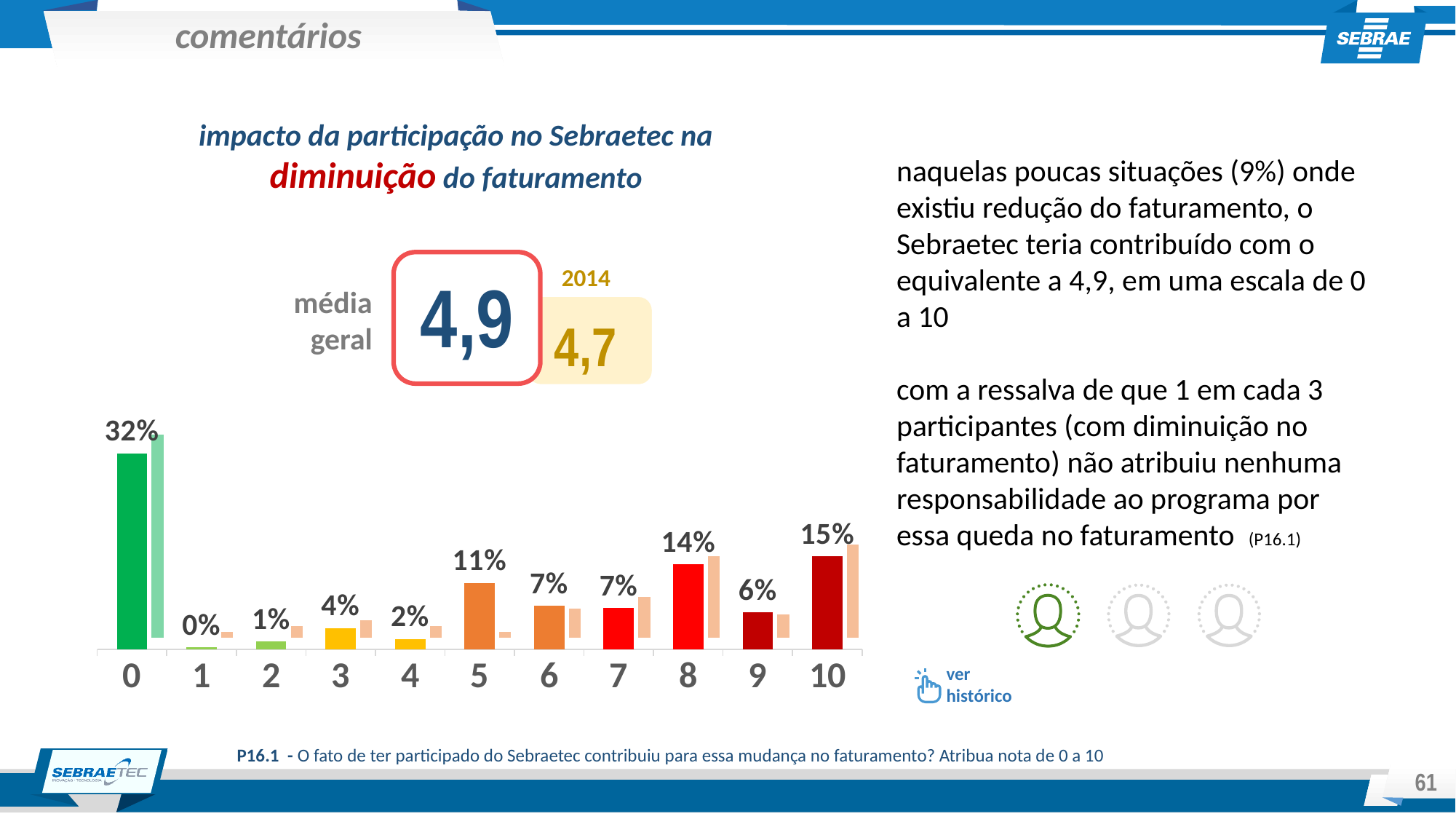
What percentage of participants gave a score of 10? 15% What percentage of participants gave a score of 8? 14% What kind of chart is shown on the slide? bar chart What is the 'média geral' value shown above the chart? 4,9 How many score categories are shown on the x axis? 11 What percentage of participants gave a score of 5? 11% Which has a larger labelled percentage, score 8 or score 9? 8 What is the difference between the labelled percentages for score 0 and score 10? 17% Which score has the lowest labelled percentage? 1 What percentage of participants gave a score of 0? 32% What is the 2014 average value shown above the chart? 4,7 Which score has the highest labelled percentage? 0